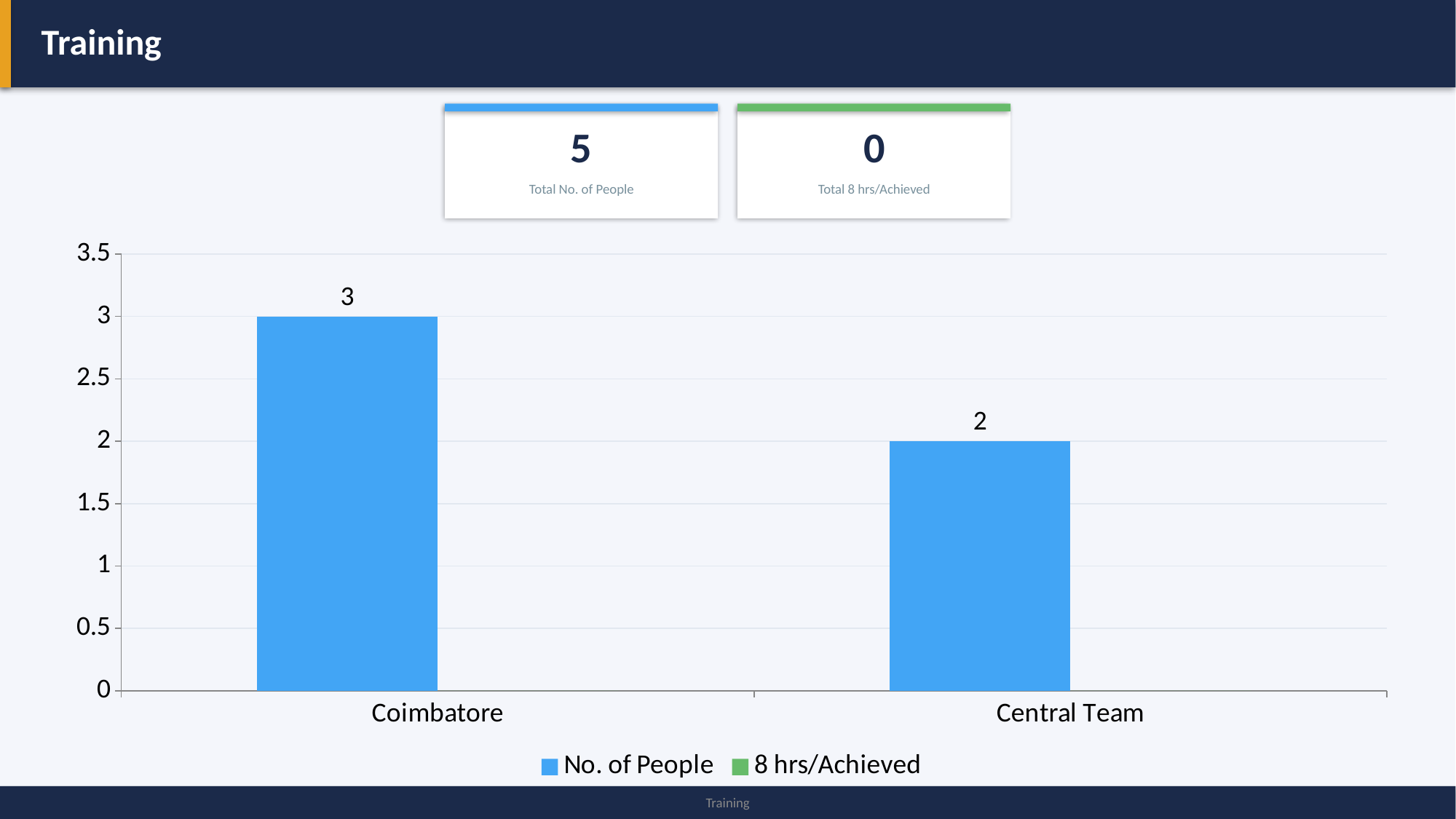
Is the value for No. of People for Coimbatore greater or less than 2.5? greater What is the value for No. of People for Central Team? 2 How many series does the legend list? 2 What kind of chart is shown on the slide? bar chart What colour are the No. of People bars? blue What is the value for No. of People for Coimbatore? 3 What is the difference in No. of People between Coimbatore and Central Team? 1 Which has more No. of People, Coimbatore or Central Team? Coimbatore Which category has the highest No. of People? Coimbatore How many categories are shown on the x axis? 2 Do the No. of People values rise or fall from Coimbatore to Central Team? fall Which category has the lowest No. of People? Central Team